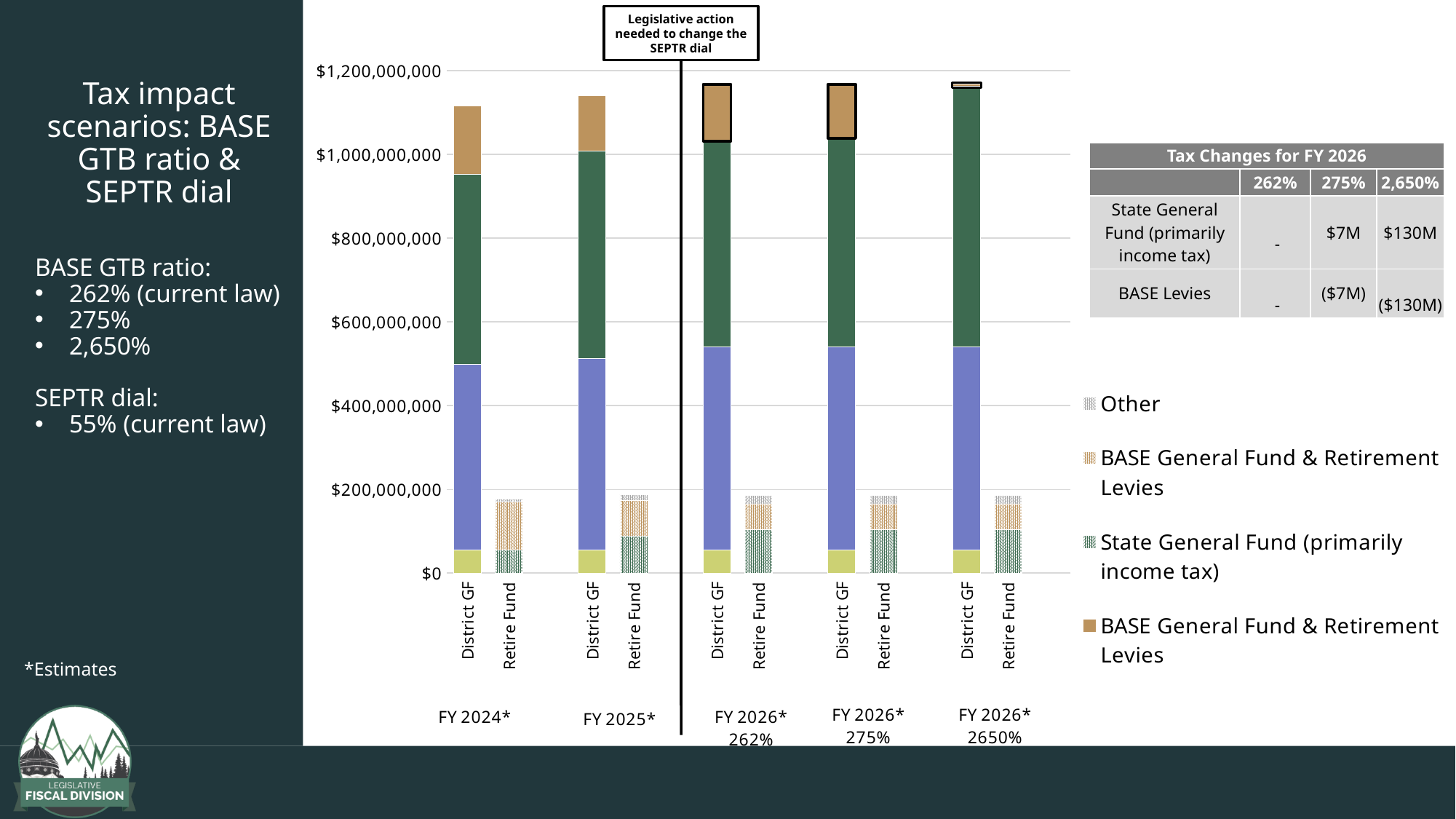
In FY 2025*, which bar is taller, District GF or Retire Fund? District GF Is the total of the Retire Fund bar for FY 2026* 275% greater or less than $400,000,000? less How many series does the chart's legend list? 4 How many bars are plotted in the chart? 10 Is the total of the District GF bar for FY 2024* greater or less than $1,000,000,000? greater Which legend entry is shown with a solid tan/brown fill? BASE General Fund & Retirement Levies Is the total of the Retire Fund bar for FY 2024* greater or less than $200,000,000? less How many fiscal year scenario groups are shown along the x axis of the chart? 5 Do the District GF bar totals rise or fall from FY 2024* to FY 2026*? Rise What does the annotation box above the vertical divider line in the chart say? Legislative action needed to change the SEPTR dial What kind of chart is shown on the slide? Stacked bar chart